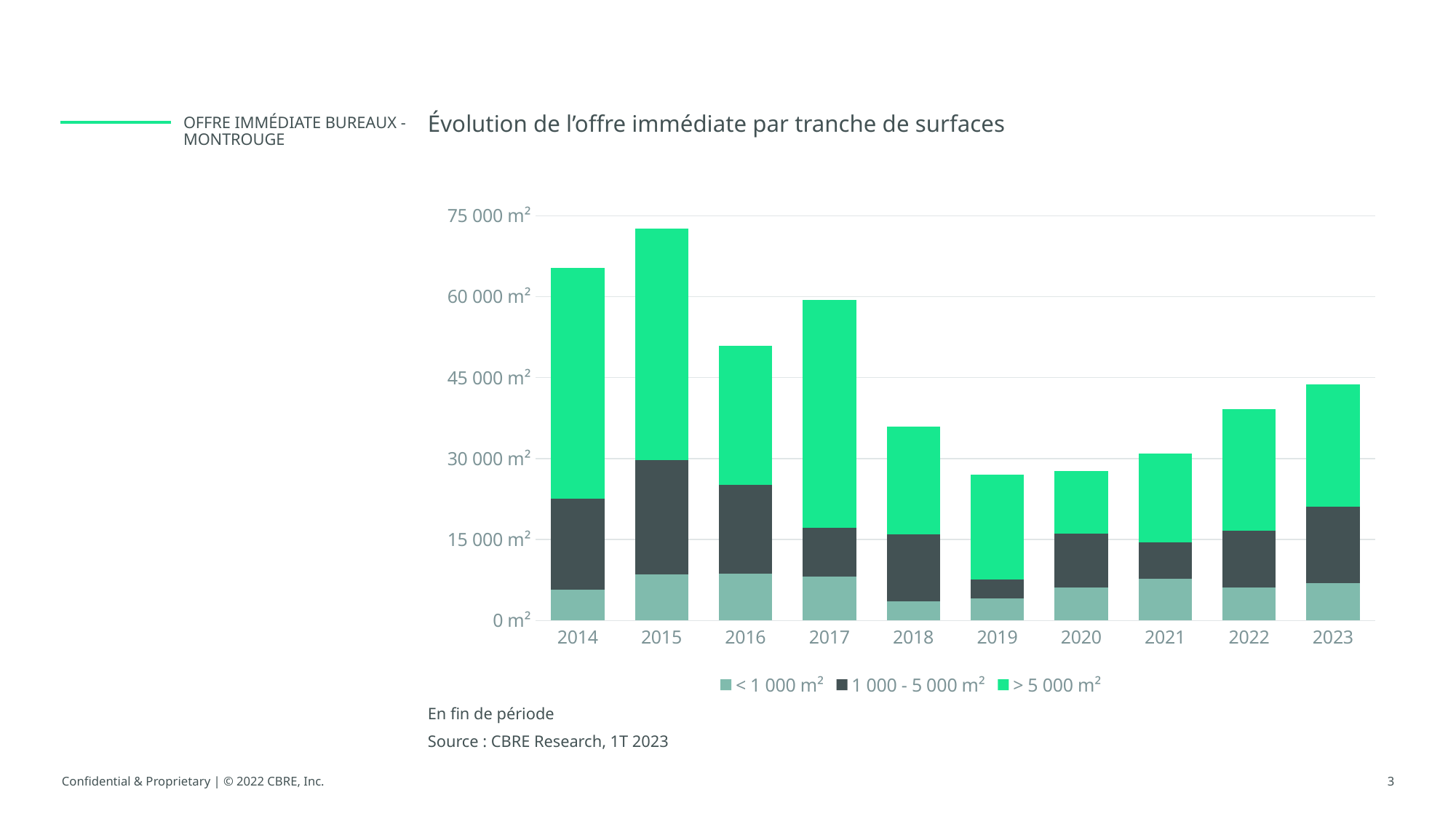
How many years are shown on the x axis? 10 Is the total for 2019 greater or less than 30 000 m²? less Which year has the larger total, 2014 or 2023? 2014 Is the total for 2016 greater or less than 45 000 m²? greater How many series does the legend list? 3 What kind of chart is shown on the slide? Stacked bar chart Do the total values rise or fall from 2015 to 2019? fall What is the title of the chart? Évolution de l'offre immédiate par tranche de surfaces Which year has the highest total immediate supply? 2015 Which year has the larger total, 2021 or 2022? 2022 Is the total for 2018 greater or less than 30 000 m²? greater